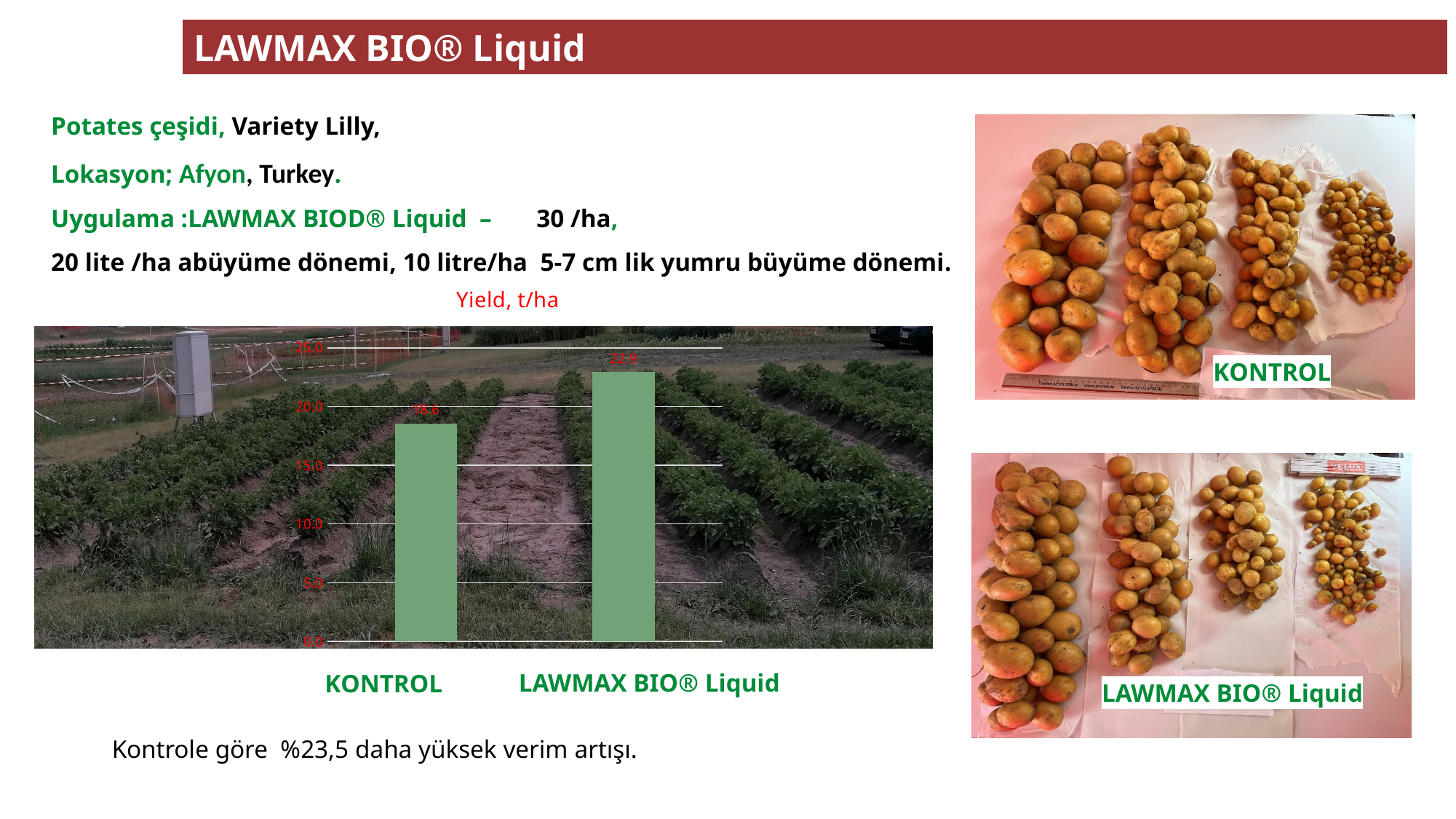
What kind of chart is shown on the slide? bar chart What is the yield value for KONTROL? 18.6 What is the title of the chart? Yield, t/ha Which is larger, the yield for KONTROL or for LAWMAX BIO® Liquid? LAWMAX BIO® Liquid Is the yield for LAWMAX BIO® Liquid greater or less than 20.0? greater How many bars does the chart show? 2 Which category has the lowest yield? KONTROL What is the yield value for LAWMAX BIO® Liquid? 22.9 Which category has the highest yield? LAWMAX BIO® Liquid Is the yield for LAWMAX BIO® Liquid greater or less than 25.0? less Is the yield for KONTROL greater or less than 20.0? less What is the difference in yield between LAWMAX BIO® Liquid and KONTROL? 4.3